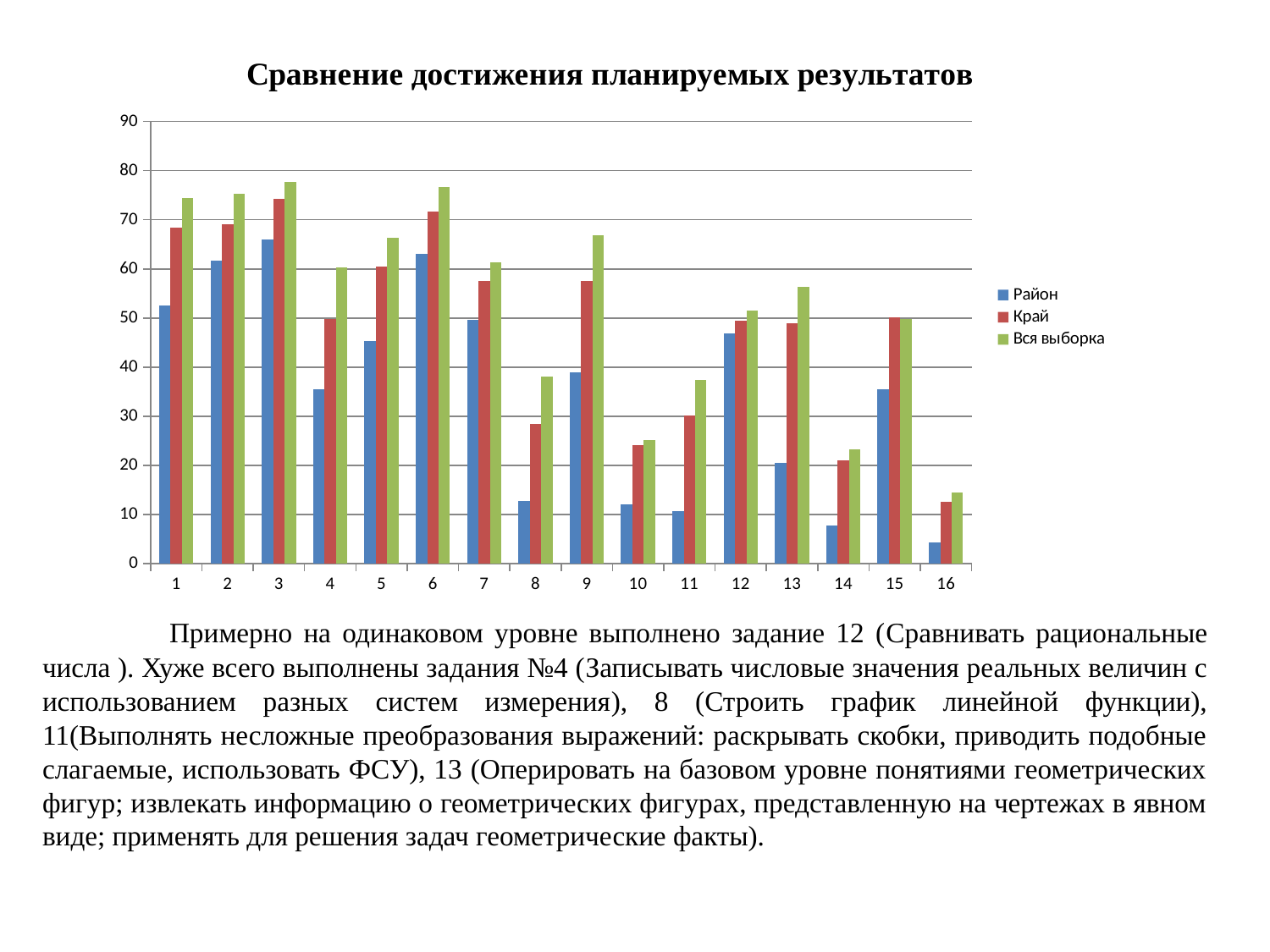
In category 13, which is larger: the value for Район or the value for Край? Край Which series is shown in green in the legend? Вся выборка What is the title of the chart? Сравнение достижения планируемых результатов How many categories are shown on the x axis? 16 Is the value for Район in category 14 greater or less than 10? less Is the value for Вся выборка in category 1 greater or less than 70? greater Is the value for Вся выборка in category 9 greater or less than 60? greater For which category is the value of the Вся выборка series lowest? 16 What kind of chart is shown on the slide? bar chart For which category is the value of the Район series lowest? 16 How many series does the legend list? 3